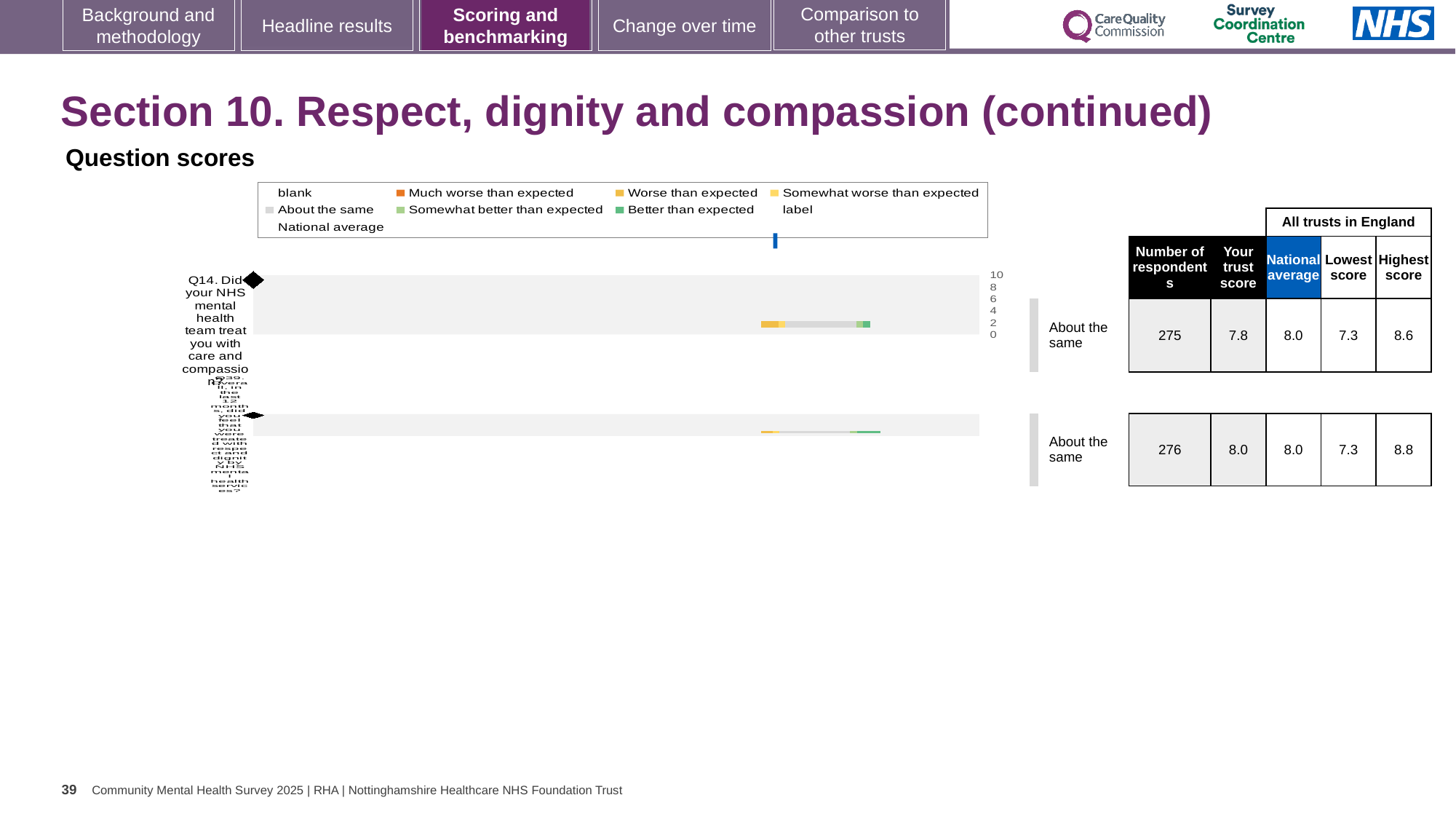
What colour does the legend use for 'Better than expected'? green How many respondents are listed for Q14? 275 Which question has the higher 'Highest score' across all trusts in England, Q14 or Q39? Q39 What is the national average for Q14 shown in the table next to the chart? 8.0 What benchmark category is shown for Q14? About the same How many questions (categories) are plotted on the chart? 2 What is the trust score for Q14 shown in the table next to the chart? 7.8 What is the highest score across all trusts in England for Q39? 8.8 What is the trust score for Q39 shown in the table next to the chart? 8.0 What is the highest value shown on the chart's numeric axis? 10 What kind of chart is shown on the slide? bar chart What is the difference between the 'Highest score' for Q39 and for Q14? 0.2